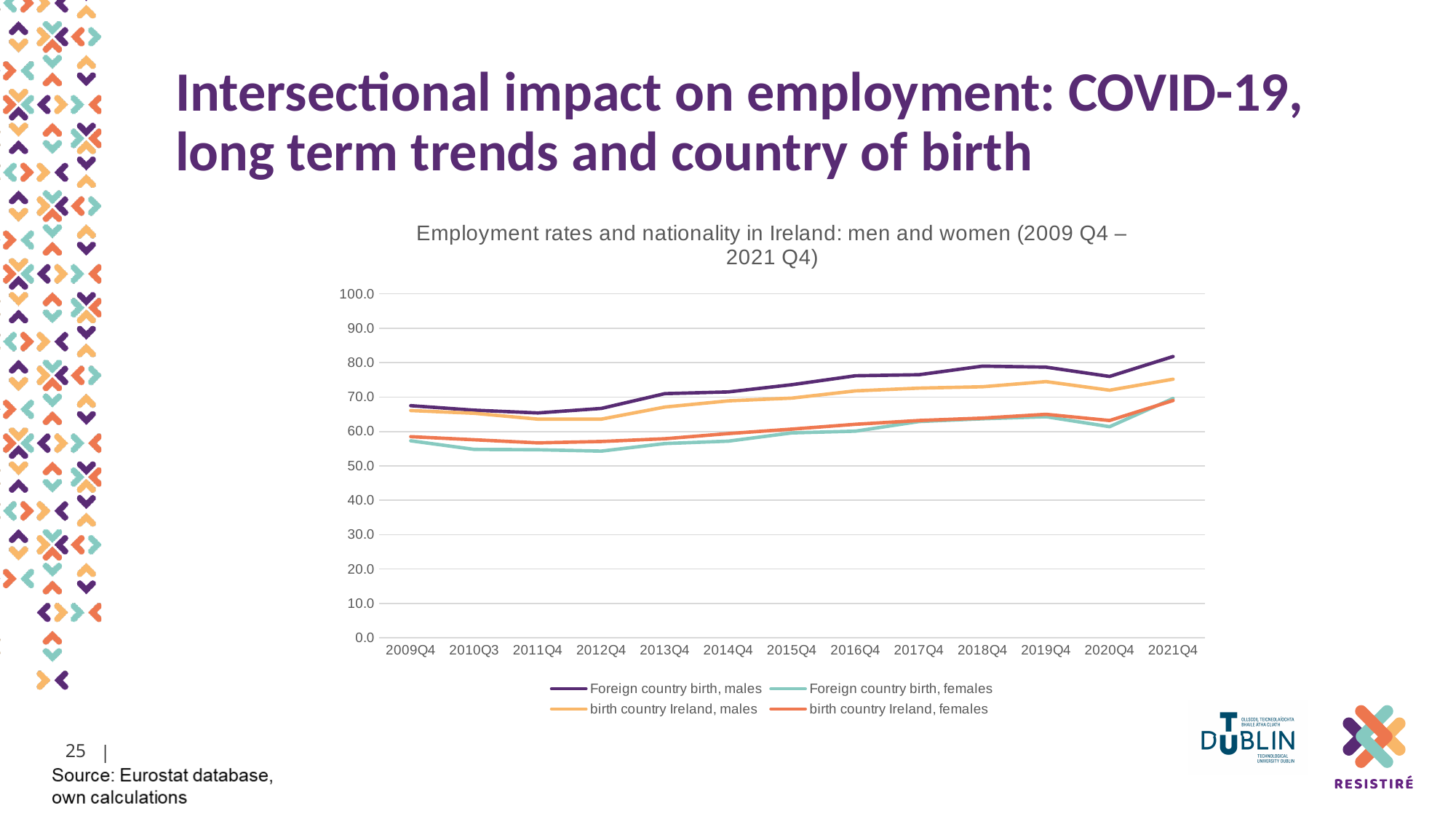
Is the value for Foreign country birth, females at 2012Q4 greater or less than 60? less Do the values for Foreign country birth, males generally rise or fall from 2009Q4 to 2021Q4? rise What is the title of the chart? Employment rates and nationality in Ireland: men and women (2009 Q4 – 2021 Q4) What kind of chart is shown on the slide? Line chart At 2009Q4, which is larger: birth country Ireland, females or Foreign country birth, females? birth country Ireland, females Is the value for birth country Ireland, males at 2020Q4 greater or less than 70? greater Is the value for Foreign country birth, males at 2021Q4 greater or less than 80? greater Which series has the lowest value at 2012Q4? Foreign country birth, females How many time points are shown along the x axis? 13 How many series does the legend list? 4 Which series has the highest value at 2021Q4? Foreign country birth, males